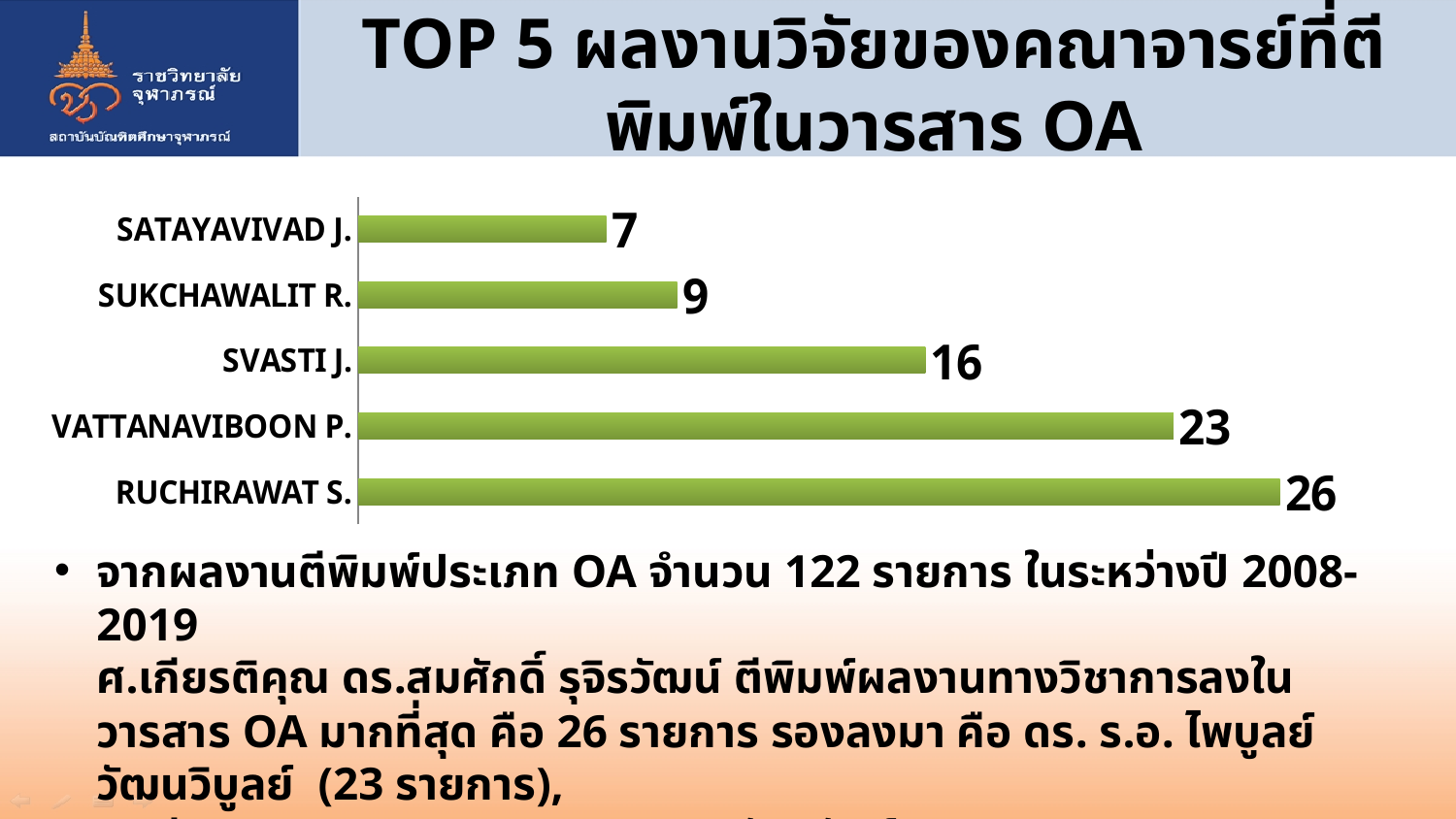
What is the value for SUKCHAWALIT R.? 9 What is the difference between the values for RUCHIRAWAT S. and VATTANAVIBOON P.? 3 Which is larger, the value for SUKCHAWALIT R. or the value for SVASTI J.? SVASTI J. What is the value for SVASTI J.? 16 How many categories are shown in the chart? 5 What is the value for VATTANAVIBOON P.? 23 What is the difference between the values for SVASTI J. and SATAYAVIVAD J.? 9 What colour are the bars in the chart? green What is the value for RUCHIRAWAT S.? 26 Which category has the highest value? RUCHIRAWAT S. Which category has the lowest value? SATAYAVIVAD J. What kind of chart is shown on the slide? bar chart